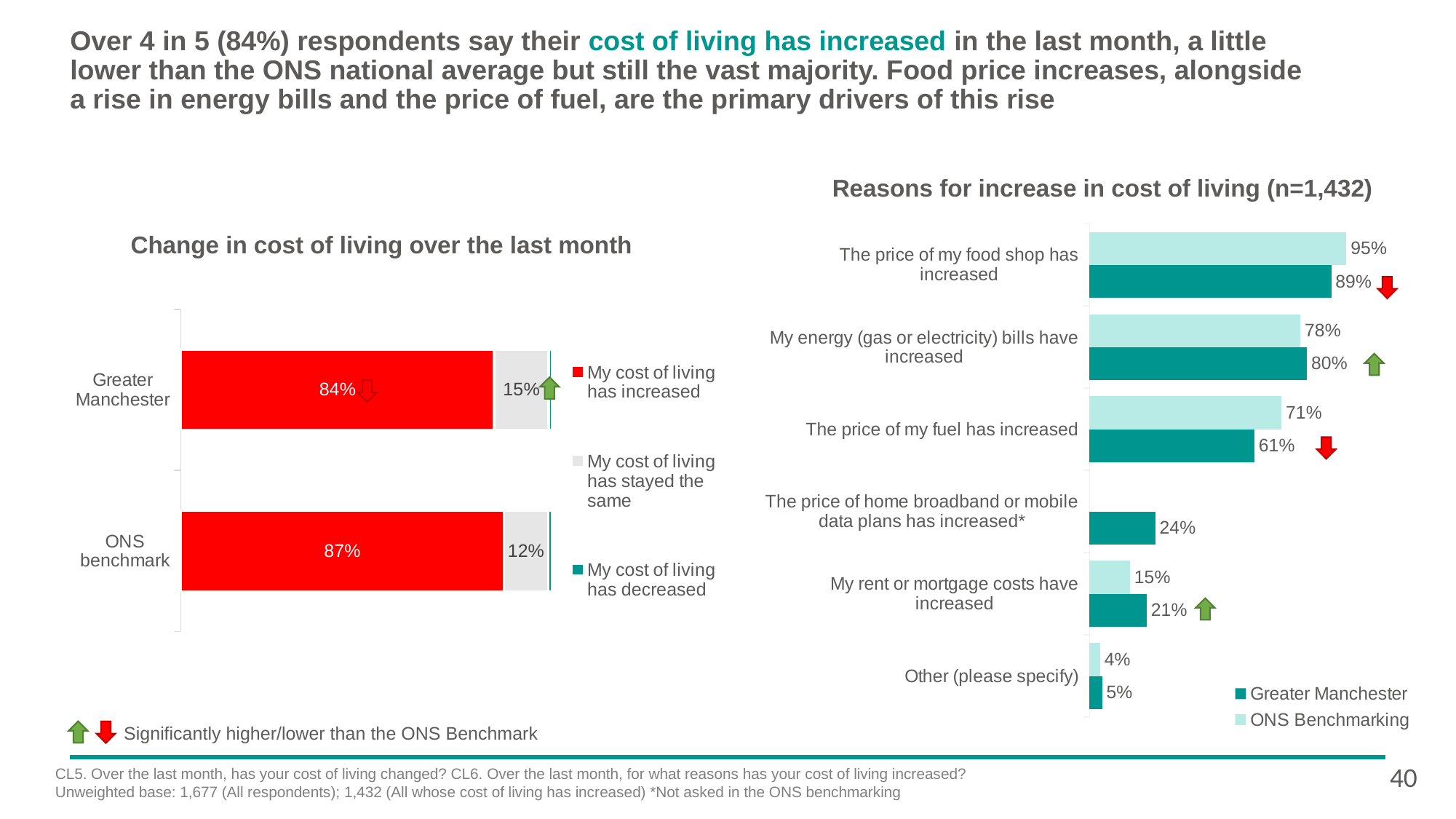
What kind of chart is 'Change in cost of living over the last month'? Stacked bar chart In the 'Reasons for increase in cost of living' chart, is the Greater Manchester value for 'My rent or mortgage costs have increased' larger or smaller than the ONS Benchmarking value? Larger How many reason categories are shown in the 'Reasons for increase in cost of living' chart? 6 How many series does the legend of the 'Change in cost of living over the last month' chart list? 3 In the 'Reasons for increase in cost of living' chart, which reason has the highest Greater Manchester value? The price of my food shop has increased In the 'Reasons for increase in cost of living' chart, what is the Greater Manchester value for 'The price of my food shop has increased'? 89% In the 'Reasons for increase in cost of living' chart, what is the difference between the ONS Benchmarking and Greater Manchester values for 'The price of my fuel has increased'? 10 percentage points In the 'Reasons for increase in cost of living' chart, which reason has the lowest ONS Benchmarking value? Other (please specify) In the 'Reasons for increase in cost of living' chart, what is the ONS Benchmarking value for 'The price of my fuel has increased'? 71% In the 'Change in cost of living over the last month' chart, what is the difference between the ONS benchmark and Greater Manchester values for 'My cost of living has increased'? 3 percentage points In the 'Change in cost of living over the last month' chart, what percentage of Greater Manchester respondents say their cost of living has increased? 84% In the 'Change in cost of living over the last month' chart, what is the ONS benchmark value for 'My cost of living has stayed the same'? 12%